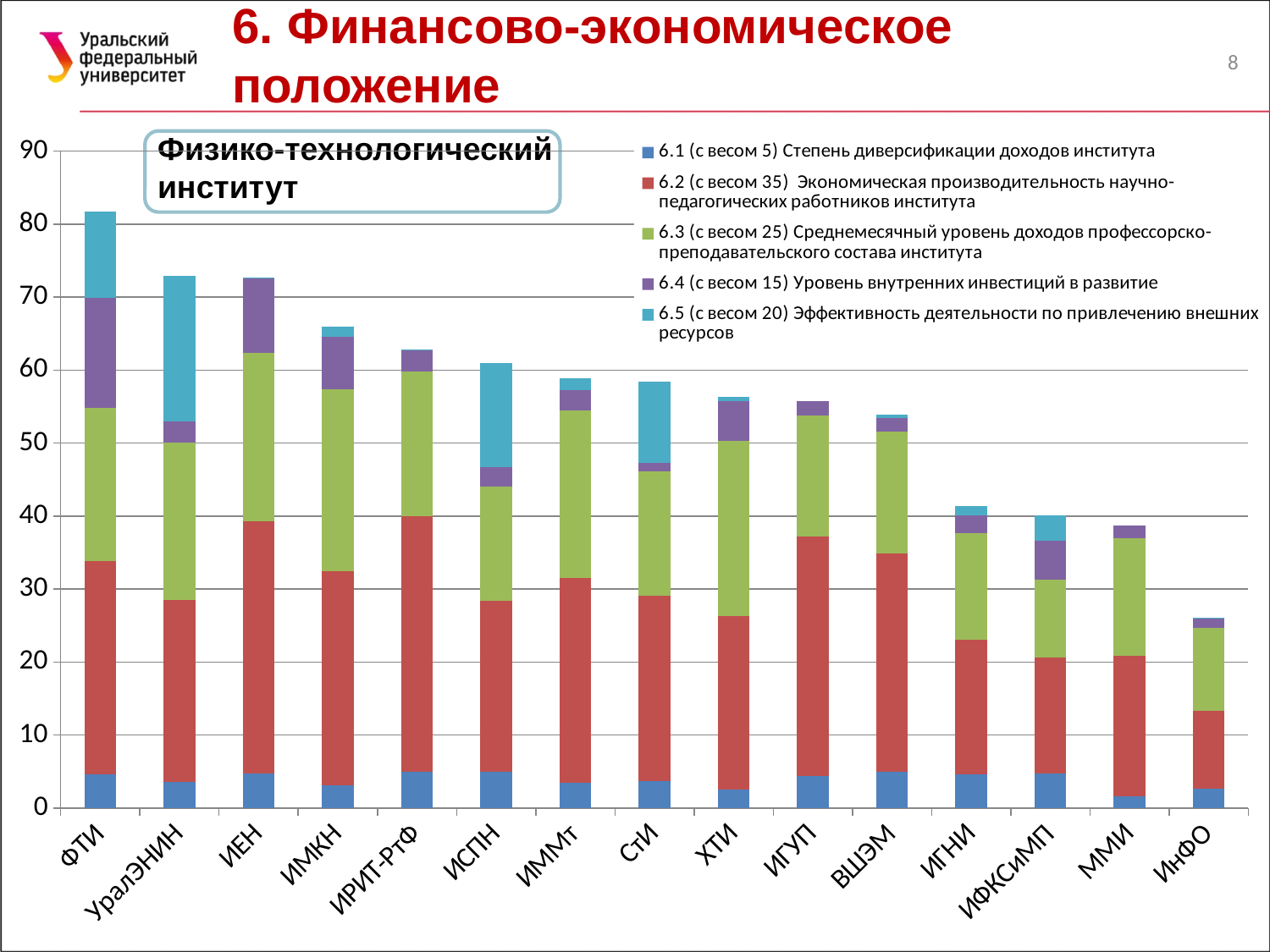
Which has the larger total bar, ИЕН or ИМКН? ИЕН Which institute is named in the callout box at the top left of the chart? Физико-технологический институт How many institutes (categories) are shown along the x axis? 15 Is the total value for ФТИ greater or less than 80? greater Which institute has the lowest total stacked bar? ИнФО Which institute has the highest total stacked bar? ФТИ Is the total value for ИнФО greater or less than 30? less What kind of chart is shown on the slide? Stacked bar chart Is the total value for УралЭНИН greater or less than 70? greater How many series does the legend list? 5 Do the total bar heights generally rise or fall from left to right along the x axis? Fall